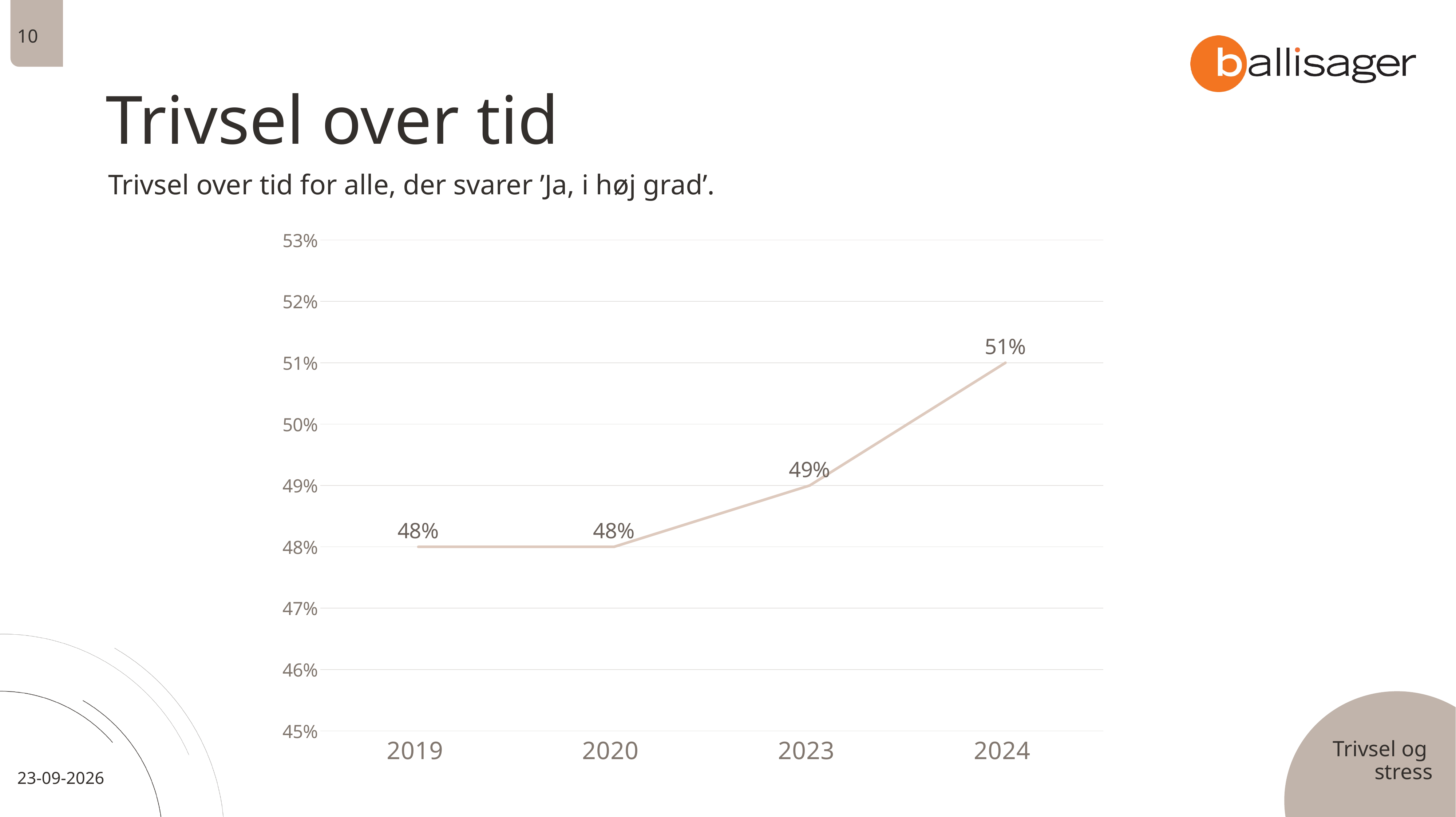
Which is larger, the value for 2023 or the value for 2020? 2023 What is the difference between the values for 2024 and 2019? 3% Which year has the highest value? 2024 What is the value for 2019? 48% What is the value for 2023? 49% What kind of chart is shown on the slide? line chart How many years are plotted on the chart? 4 What is the title of the slide containing the chart? Trivsel over tid Do the values rise or fall from 2020 to 2024? rise Is the value for 2024 greater or less than 50%? greater What is the value for 2024? 51% What is the difference between the values for 2024 and 2023? 2%